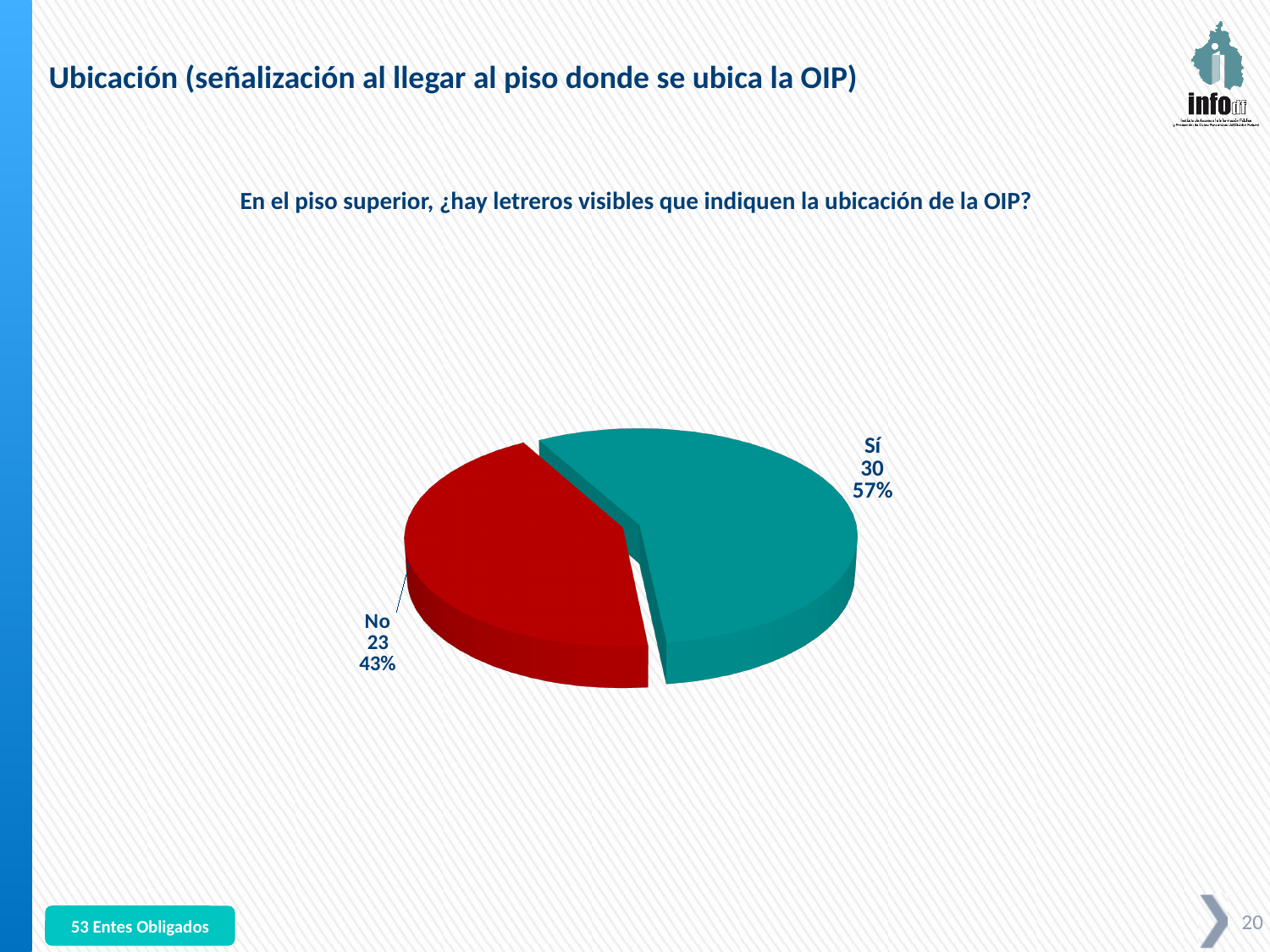
How many slices does the pie chart have? 2 What is the count for the 'Sí' slice? 30 What kind of chart is shown on the slide? pie chart What percentage share does the 'Sí' slice represent? 57% What percentage share does the 'No' slice represent? 43% Which slice is the largest? Sí What is the count for the 'No' slice? 23 What is the difference between the counts for 'Sí' and 'No'? 7 Which is larger, the count for 'Sí' or the count for 'No'? Sí What colour is the 'No' slice? red What is the total of the two slice counts? 53 Which slice is the smallest? No